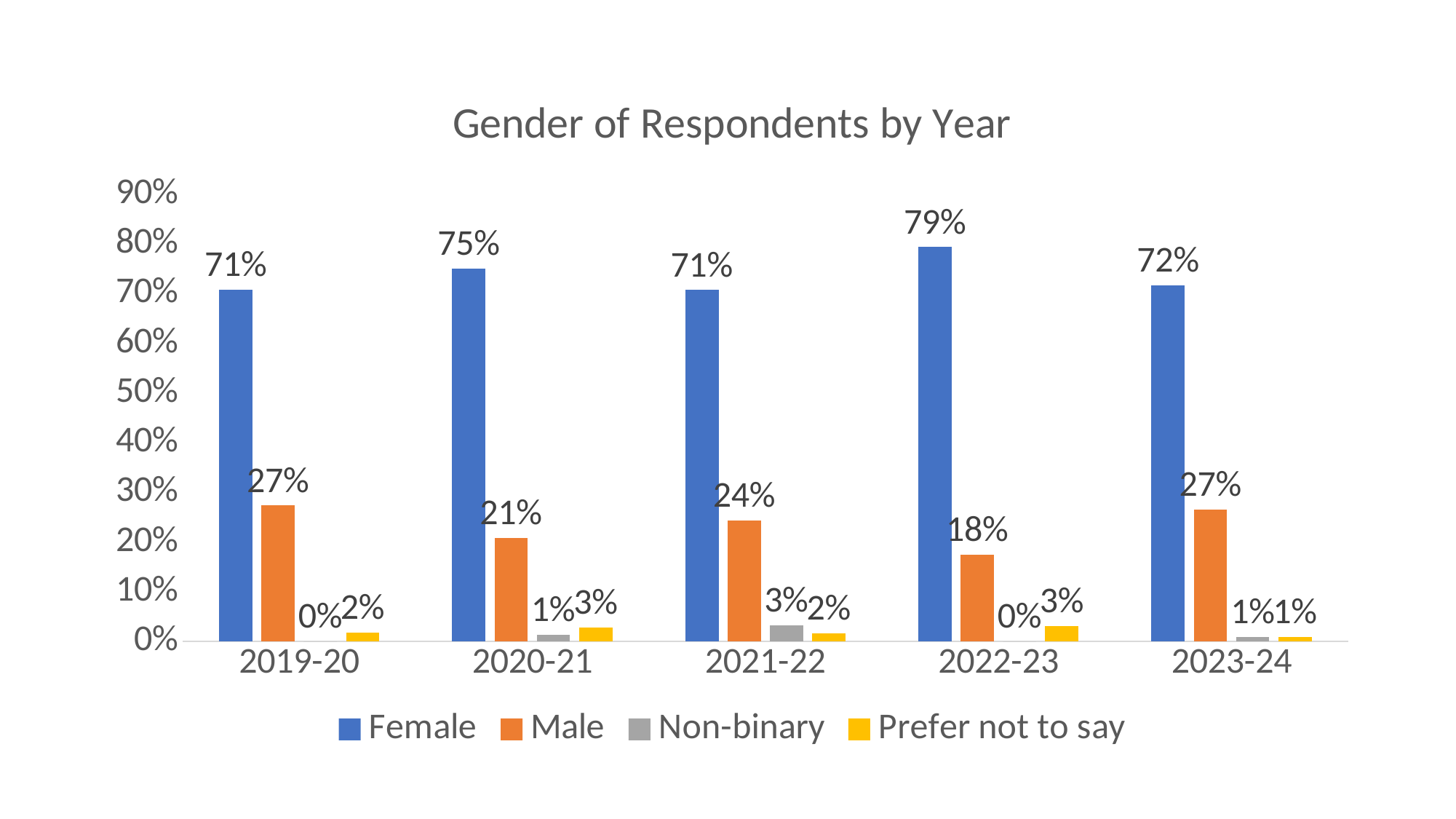
Which is larger in 2021-22, the Non-binary value or the Prefer not to say value? Non-binary What is the title of the chart? Gender of Respondents by Year What is the Prefer not to say value for 2023-24? 1% What is the Non-binary value for 2021-22? 3% What is the Female value for 2022-23? 79% What is the difference between the Female and Male values in 2019-20? 44% How many series does the legend list? 4 What kind of chart is this? Bar chart In which year is the Female value highest? 2022-23 How many years are shown on the x axis? 5 What is the Male value for 2020-21? 21% In which year is the Male value lowest? 2022-23